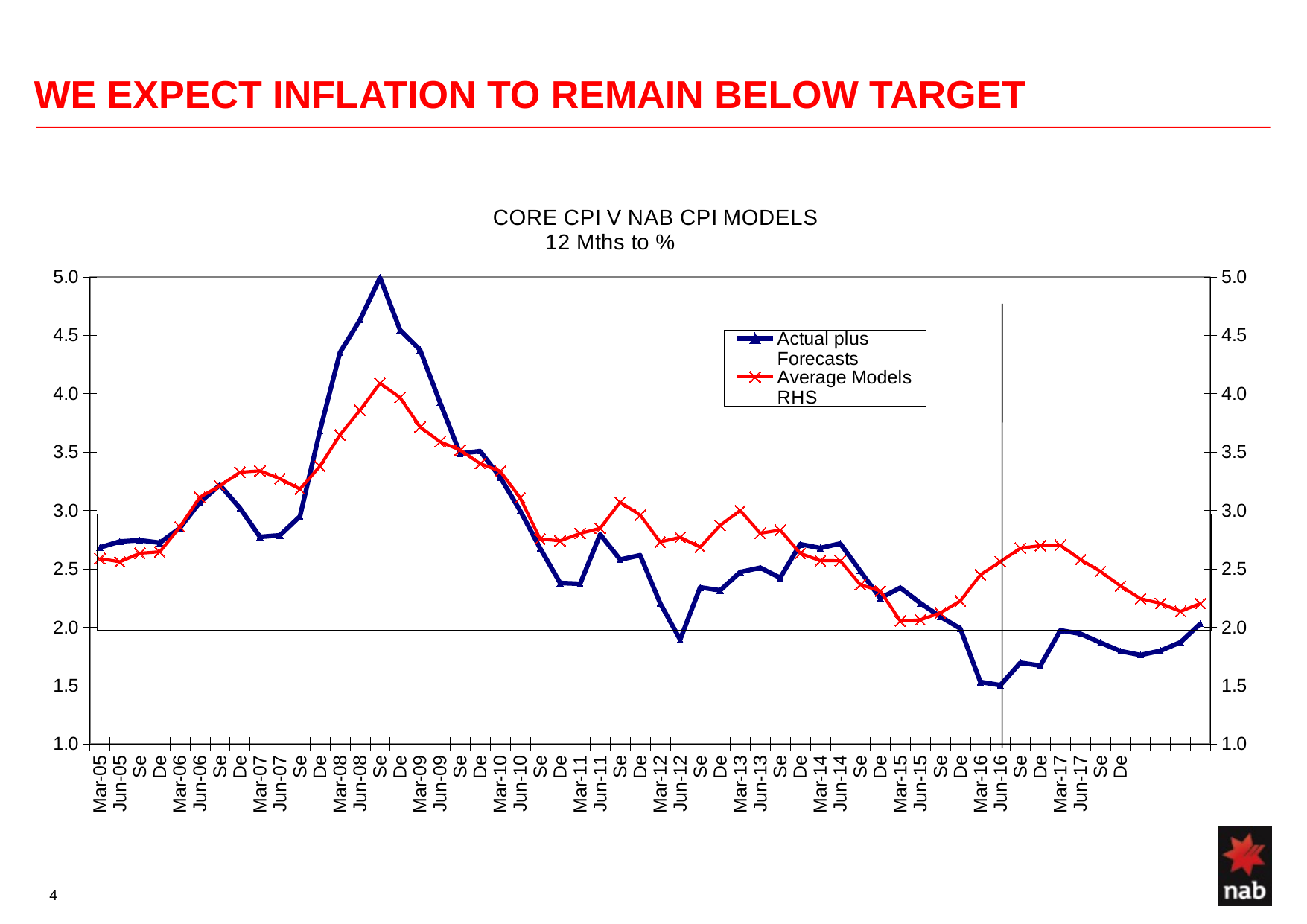
Is the value of Actual plus Forecasts at Mar-16 greater or less than 2.0? less At Sep-08, which series has the higher value, Actual plus Forecasts or Average Models RHS? Actual plus Forecasts At Dec-10, which series has the higher value, Actual plus Forecasts or Average Models RHS? Average Models RHS What is the title of the chart? CORE CPI V NAB CPI MODELS At which period does the Average Models RHS series reach its highest value? Sep-08 At which period does the Actual plus Forecasts series reach its highest value? Sep-08 How many series does the legend list? 2 Which colour is used for the Actual plus Forecasts series? Blue Is the value of Average Models RHS at Sep-08 greater or less than 3.5? greater Does the Average Models RHS series rise or fall from Mar-17 to the end of the chart? Fall What kind of chart is shown on the slide? Line chart Is the value of Actual plus Forecasts at Sep-08 greater or less than 4.5? greater